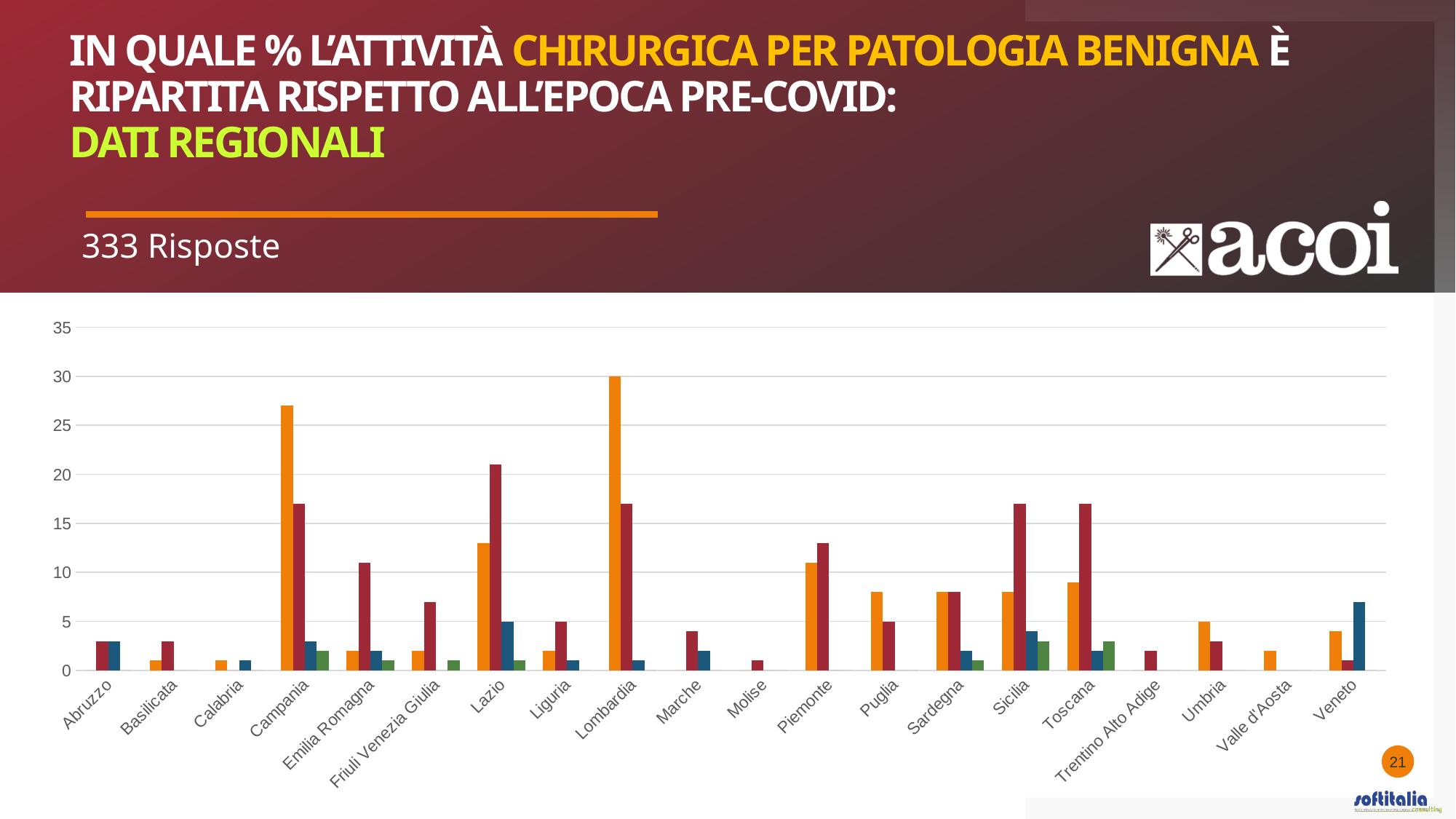
How many regions are listed along the x axis of the chart? 20 How many responses (Risposte) does the slide say the chart is based on? 333 Which has the taller orange bar, Campania or Lombardia? Lombardia Is the dark red bar for Piemonte greater or less than 10? greater Is the orange bar for Campania greater or less than 25? greater What kind of chart is shown on the slide? bar chart Which region has the tallest dark red bar? Lazio Is the orange bar for Umbria greater or less than 10? less Which region has the tallest orange bar? Lombardia Which has the taller dark red bar, Lazio or Campania? Lazio